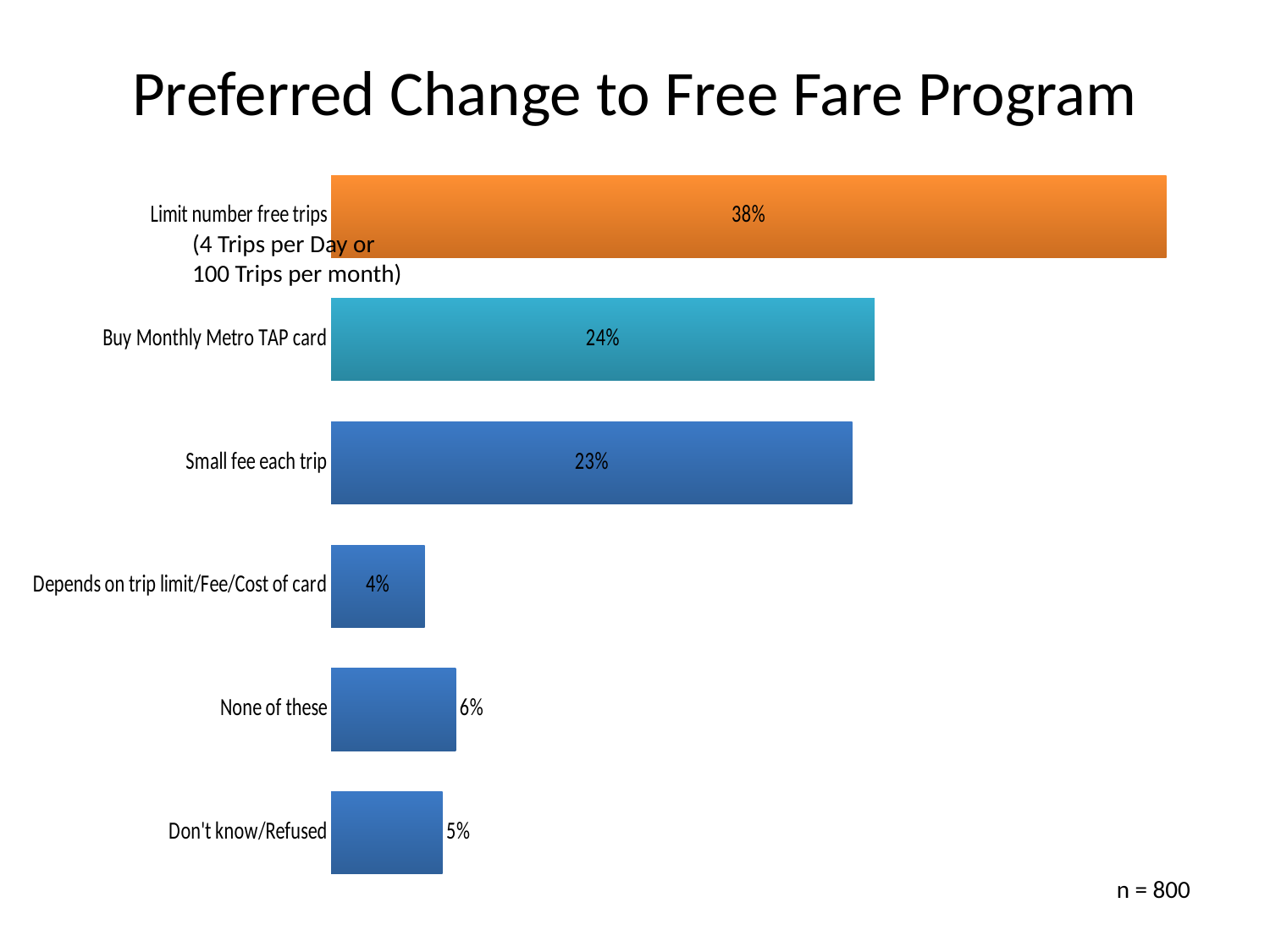
Which category has the highest value? Limit number free trips What percentage of respondents preferred to limit the number of free trips? 38% What is the title of the chart? Preferred Change to Free Fare Program What is the value for Small fee each trip? 23% What kind of chart is shown on the slide? Bar chart How many categories are shown in the chart? 6 Which is larger, None of these or Don't know/Refused? None of these What is the value for Don't know/Refused? 5% What is the difference between the values for Limit number free trips and Buy Monthly Metro TAP card? 14% What is the value for Depends on trip limit/Fee/Cost of card? 4% What is the value for Buy Monthly Metro TAP card? 24% Which category has the lowest value? Depends on trip limit/Fee/Cost of card